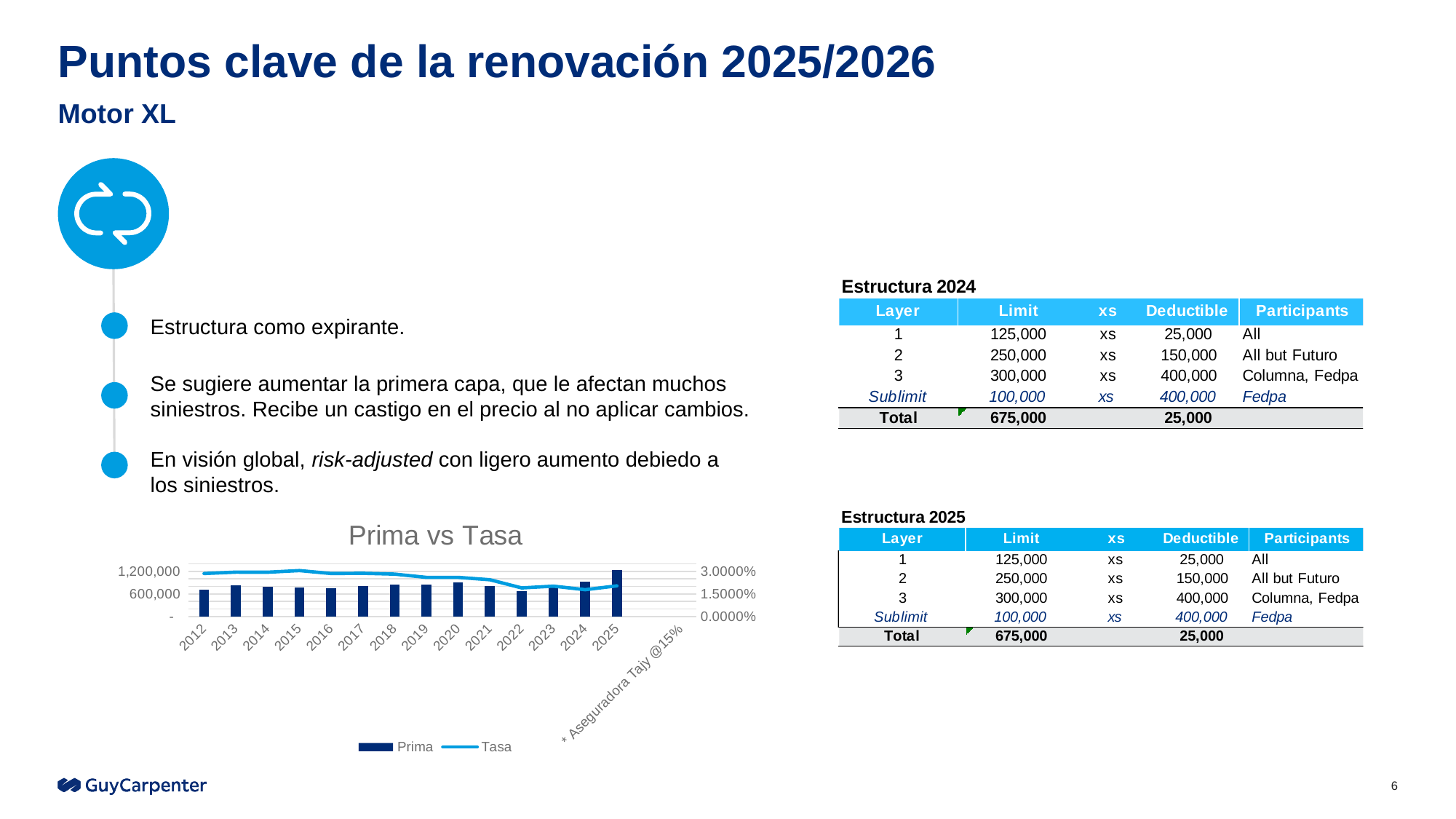
Which series in the "Prima vs Tasa" chart is drawn as a line? Tasa In the "Prima vs Tasa" chart, which is larger: the Prima bar for 2025 or the Prima bar for 2012? 2025 In the "Prima vs Tasa" chart, is the Prima value for 2012 greater or less than 1,200,000? less How many years are shown on the x axis of the "Prima vs Tasa" chart? 14 How many series does the legend of the "Prima vs Tasa" chart list? 2 In the "Prima vs Tasa" chart, does the Tasa line generally rise or fall from 2015 to 2022? fall In the "Prima vs Tasa" chart, is the Tasa value for 2012 greater or less than 1.5000%? greater What kind of chart is the "Prima vs Tasa" chart? A combined bar and line chart What is the title of the chart on the slide? Prima vs Tasa In the "Prima vs Tasa" chart, which is larger: the Tasa value for 2012 or the Tasa value for 2025? 2012 In the "Prima vs Tasa" chart, is the Prima value for 2025 greater or less than 600,000? greater In the "Prima vs Tasa" chart, which year has the highest Prima bar? 2025